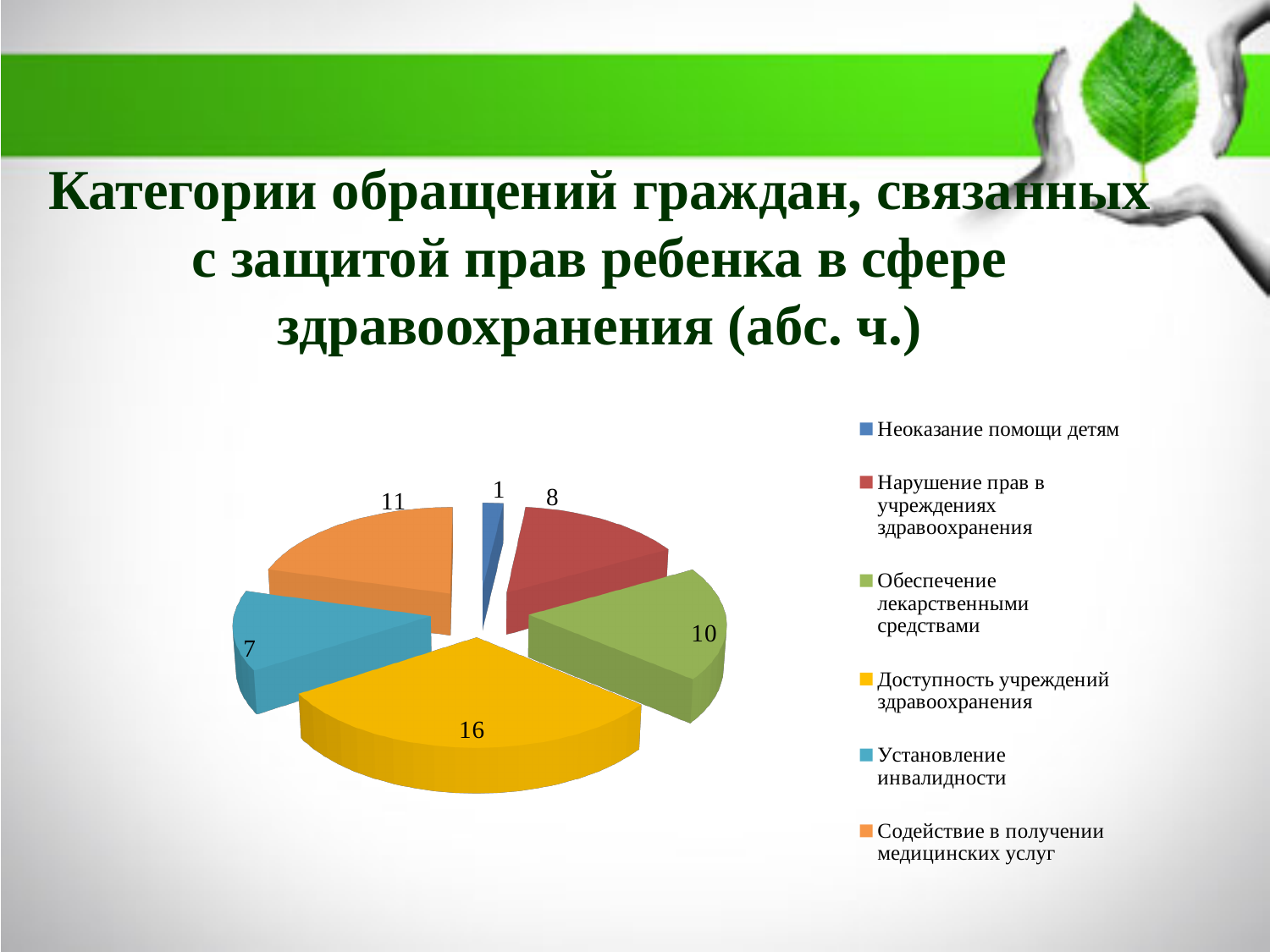
What type of chart is shown on the slide? pie chart How many categories does the pie chart have? 6 What is the total of all the values in the pie chart? 53 What colour is the slice for "Обеспечение лекарственными средствами"? green What is the value for "Доступность учреждений здравоохранения"? 16 What is the value for "Содействие в получении медицинских услуг"? 11 What is the value for "Установление инвалидности"? 7 Which is larger: "Нарушение прав в учреждениях здравоохранения" or "Содействие в получении медицинских услуг"? Содействие в получении медицинских услуг What is the value for "Неоказание помощи детям"? 1 Which category has the smallest value? Неоказание помощи детям Which category has the largest value? Доступность учреждений здравоохранения What is the difference between the values for "Доступность учреждений здравоохранения" and "Обеспечение лекарственными средствами"? 6